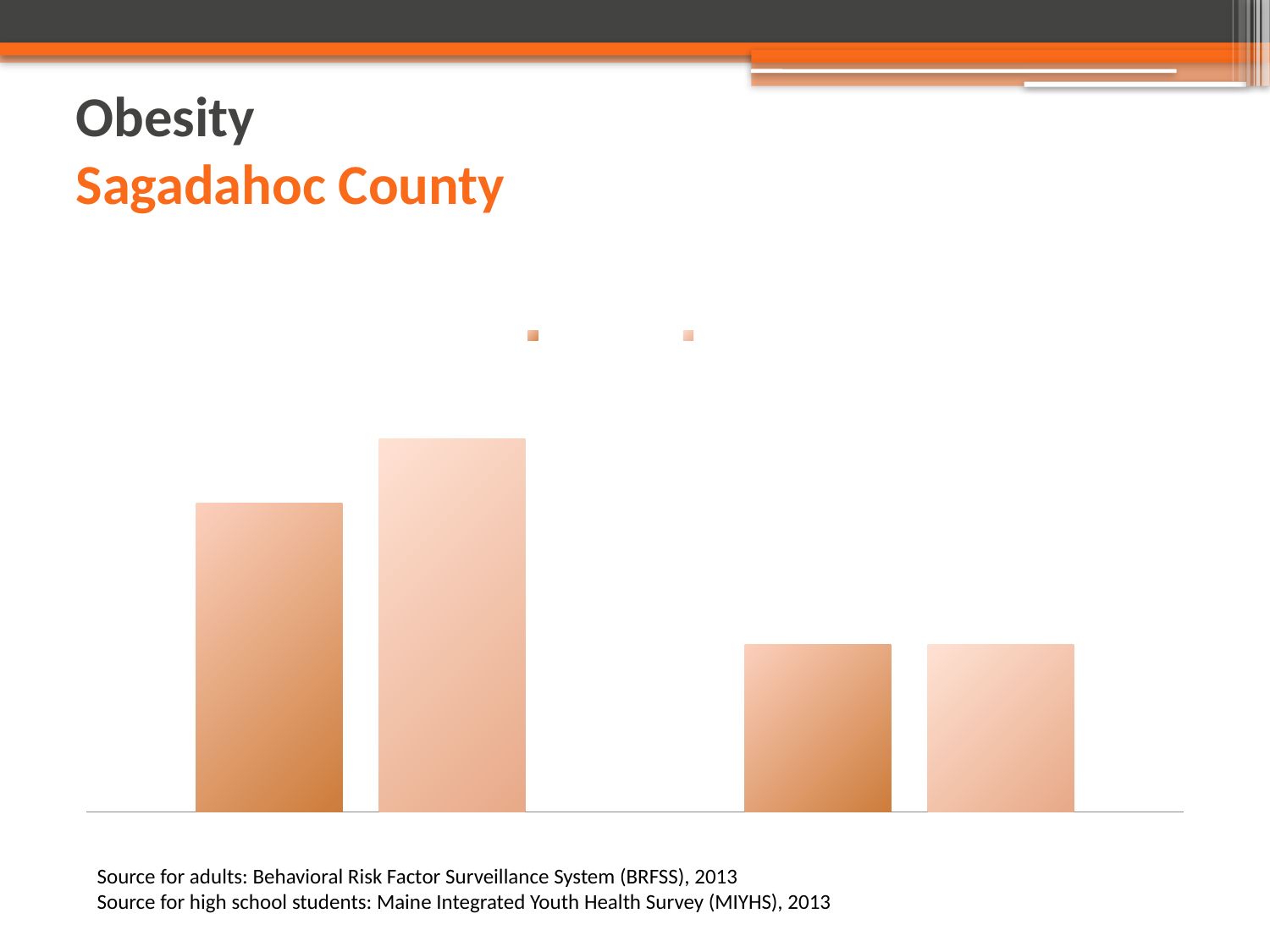
What colour are the bars in the chart? orange How many bars are plotted in the chart? 4 How many series does the chart's legend list? 2 What kind of chart is shown on the slide? bar chart Which bar is the tallest in the chart, counting from the left? the second bar In the left group of bars, is the left bar or the right bar taller? the right bar What is the title of the slide containing the chart? Obesity Sagadahoc County How many groups of bars does the chart show along the x axis? 2 Do the bar heights rise or fall from the left group to the right group? fall Which group of bars is taller overall, the left group or the right group? the left group Is the first bar from the left taller or shorter than the third bar from the left? taller